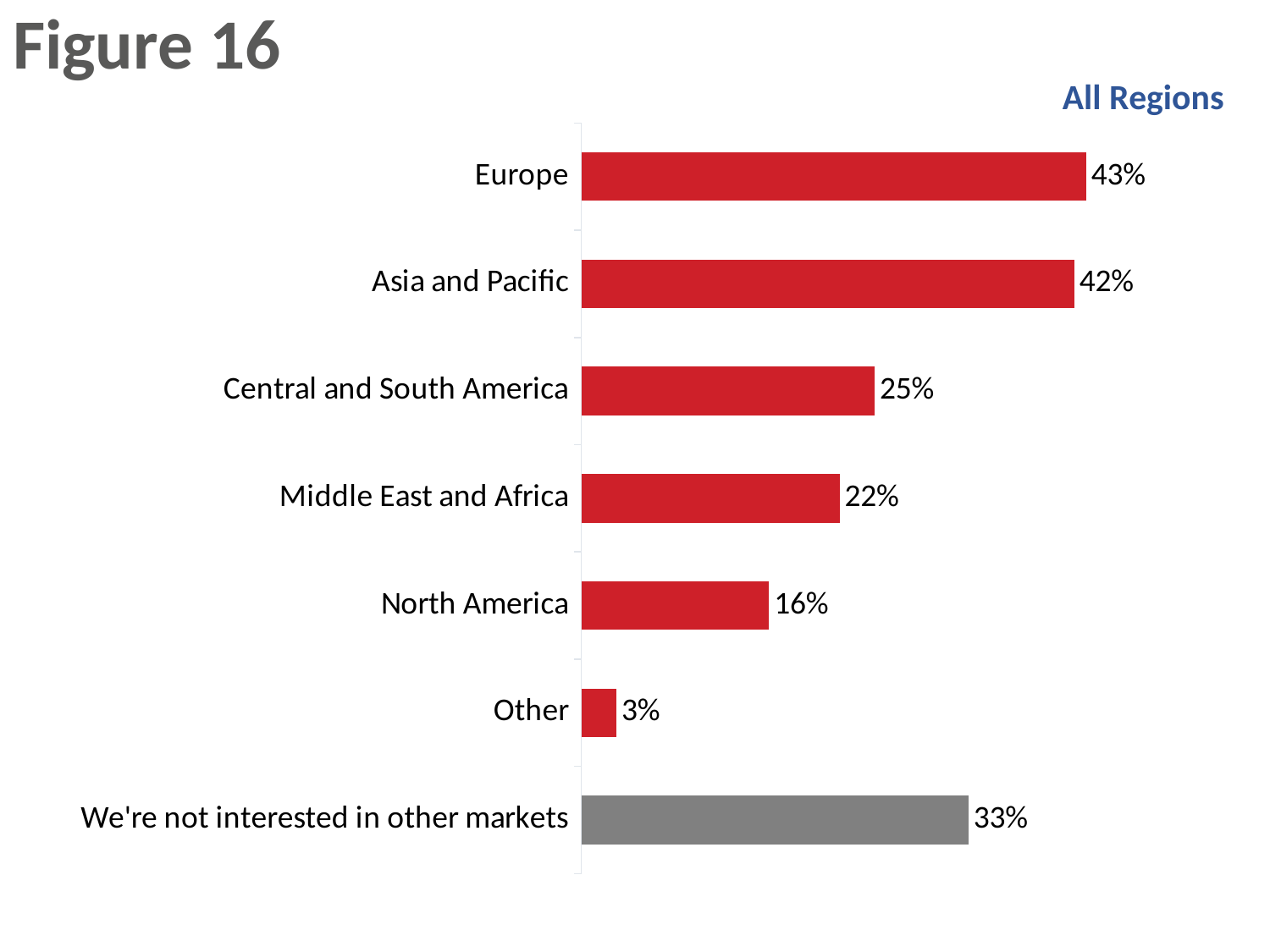
What kind of chart is shown on the slide? Bar chart How many categories are shown in the chart? 7 Which bar is coloured grey rather than red? We're not interested in other markets What is the value for North America? 16% Which category has the lowest value? Other What is the value for Central and South America? 25% What is the difference between the values for Europe and Asia and Pacific? 1% Which is larger, the value for Middle East and Africa or the value for North America? Middle East and Africa What is the value for Europe? 43% Which category has the highest value? Europe What is the difference between the values for Central and South America and Middle East and Africa? 3% What is the value for "We're not interested in other markets"? 33%